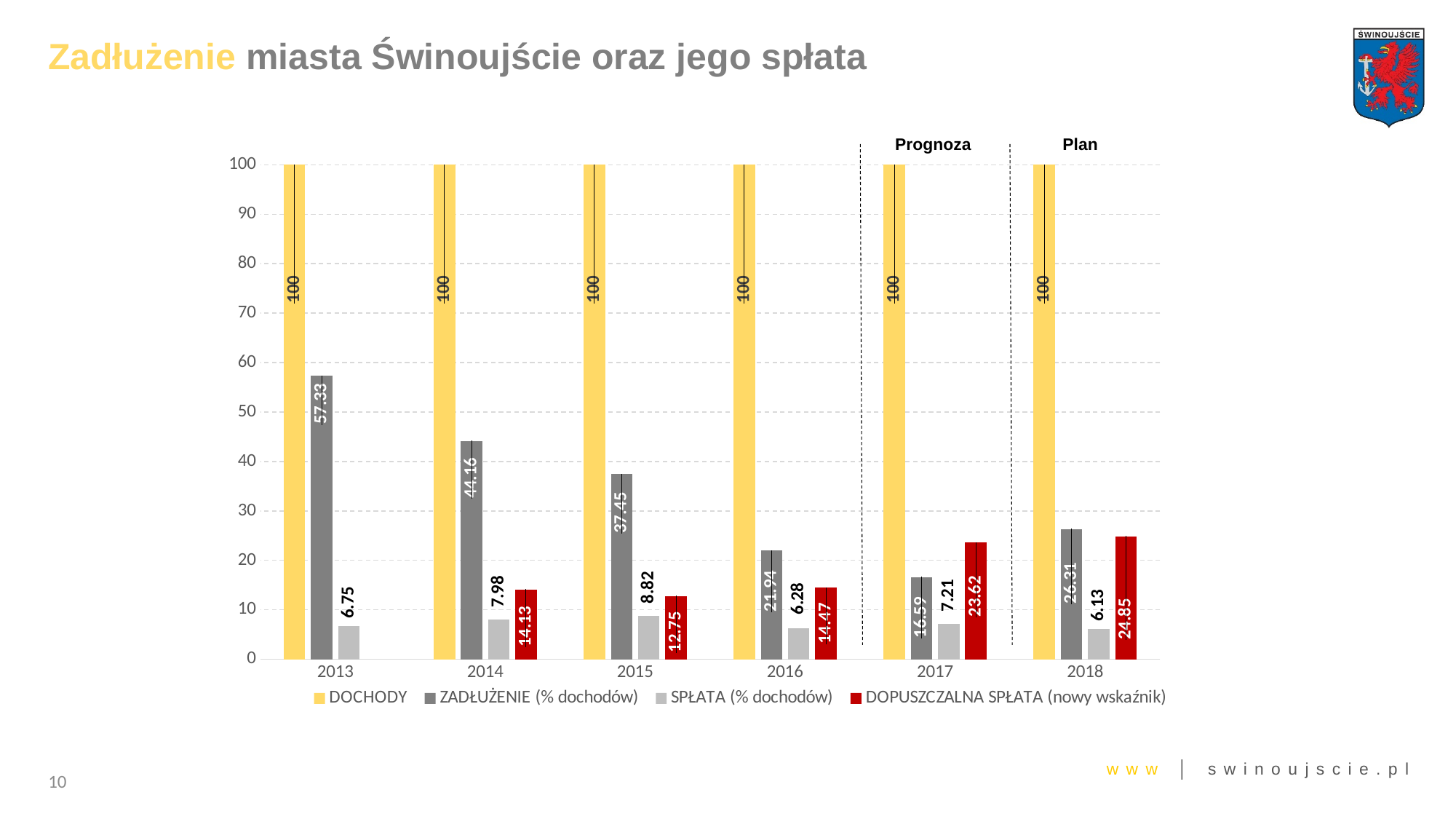
What is the difference between ZADŁUŻENIE (% dochodów) in 2013 and in 2014? 13.17 How many years are shown on the x axis of the chart? 6 Does ZADŁUŻENIE (% dochodów) rise or fall from 2013 to 2017? fall What is the value of ZADŁUŻENIE (% dochodów) for 2013? 57.33 What is the value of SPŁATA (% dochodów) for 2015? 8.82 What is the value of DOPUSZCZALNA SPŁATA (nowy wskaźnik) for 2017? 23.62 Which year has the larger ZADŁUŻENIE (% dochodów) value, 2017 or 2018? 2018 What type of chart is shown on the slide? bar chart How many series does the legend list? 4 In which year is ZADŁUŻENIE (% dochodów) the highest? 2013 Which year is labelled 'Plan' above the chart? 2018 In which year is SPŁATA (% dochodów) the lowest? 2018